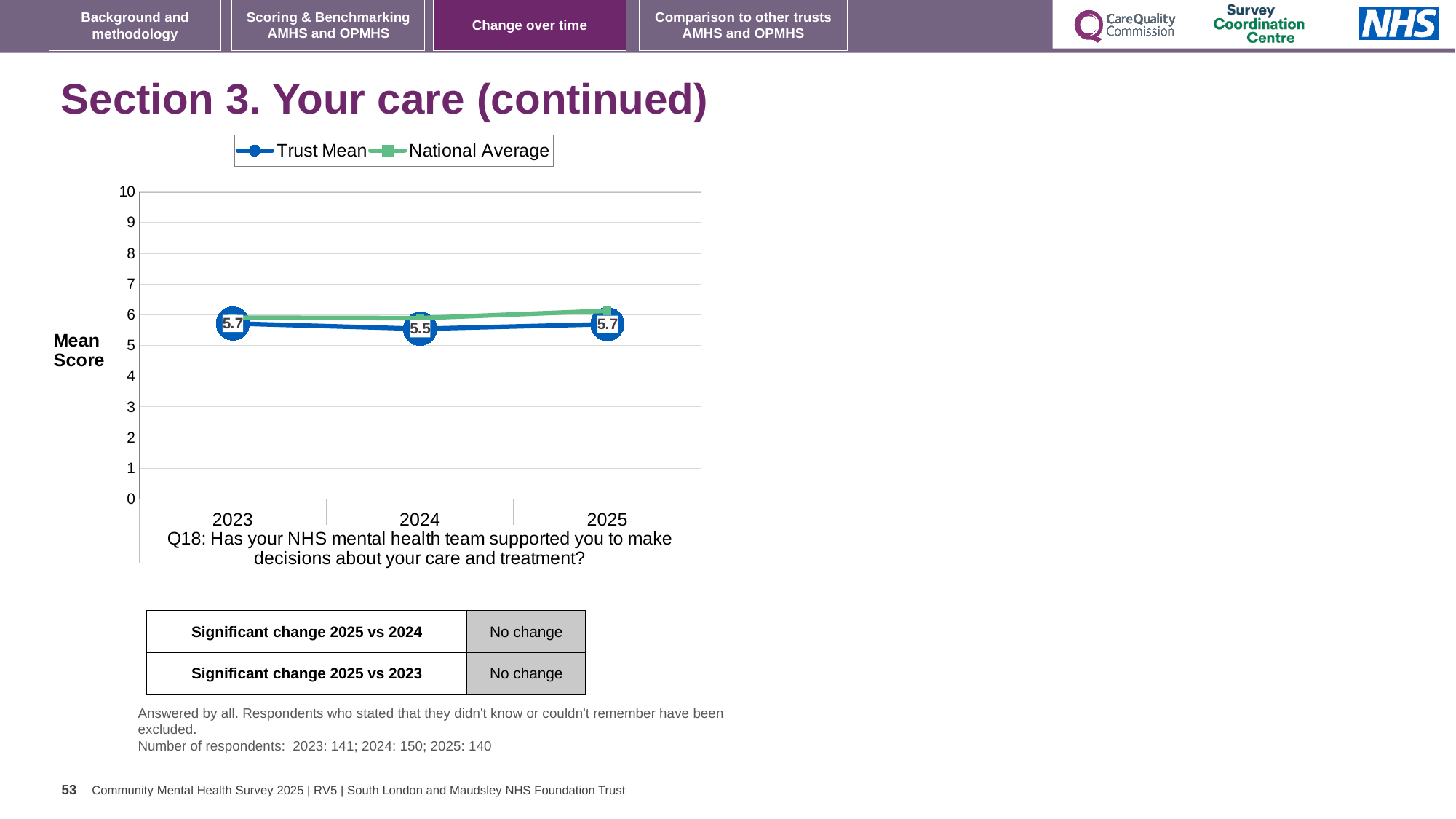
What is the Trust Mean score for 2025? 5.7 Is the National Average value for 2023 greater or less than 7? less How many years are plotted on the x axis? 3 What is the Trust Mean score for 2023? 5.7 What kind of chart is shown on the slide? line chart How many series does the legend list? 2 Which is larger, the Trust Mean score for 2023 or for 2024? 2023 In which year is the Trust Mean score lowest? 2024 Does the Trust Mean rise or fall from 2024 to 2025? rise What is the difference between the Trust Mean scores for 2025 and 2024? 0.2 In 2024, which series has the higher value, Trust Mean or National Average? National Average What is the Trust Mean score for 2024? 5.5